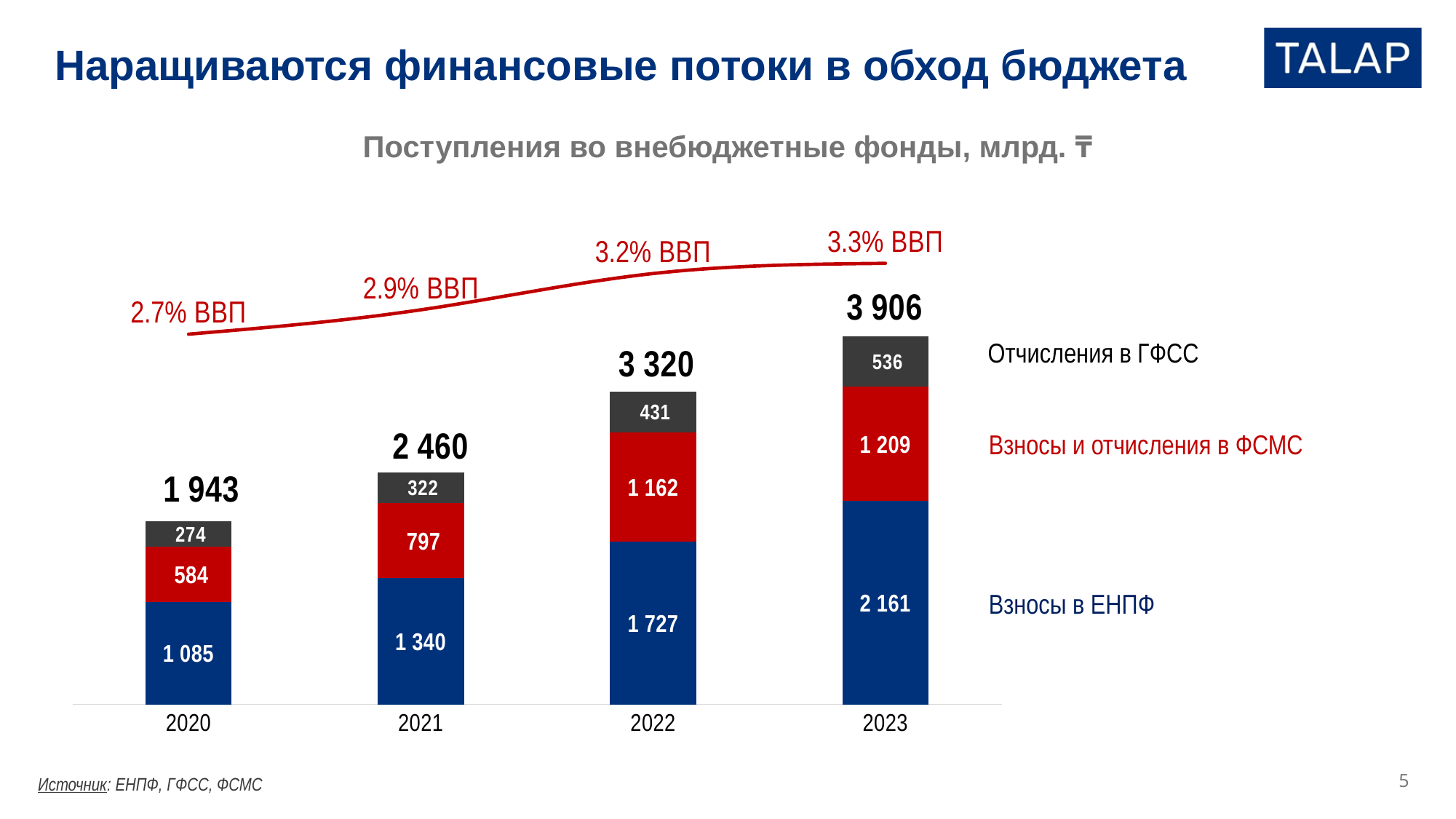
What is the value of Взносы и отчисления в ФСМС for 2023? 1 209 Which year has the highest total of поступления во внебюджетные фонды? 2023 Which is larger: Взносы и отчисления в ФСМС in 2021 or Отчисления в ГФСС in 2023? Взносы и отчисления в ФСМС in 2021 What is the difference between the total for 2022 and the total for 2021? 860 What percentage of ВВП is shown for 2022 on the red line? 3.2% ВВП What is the value of Взносы в ЕНПФ for 2022? 1 727 Which year has the lowest value of Взносы в ЕНПФ? 2020 How many years are shown on the x axis of the chart? 4 What is the value of Отчисления в ГФСС for 2021? 322 What is the total of the stacked bar for 2020? 1 943 How many series are stacked in each bar of the chart? 3 What is the total of the stacked bar for 2023? 3 906